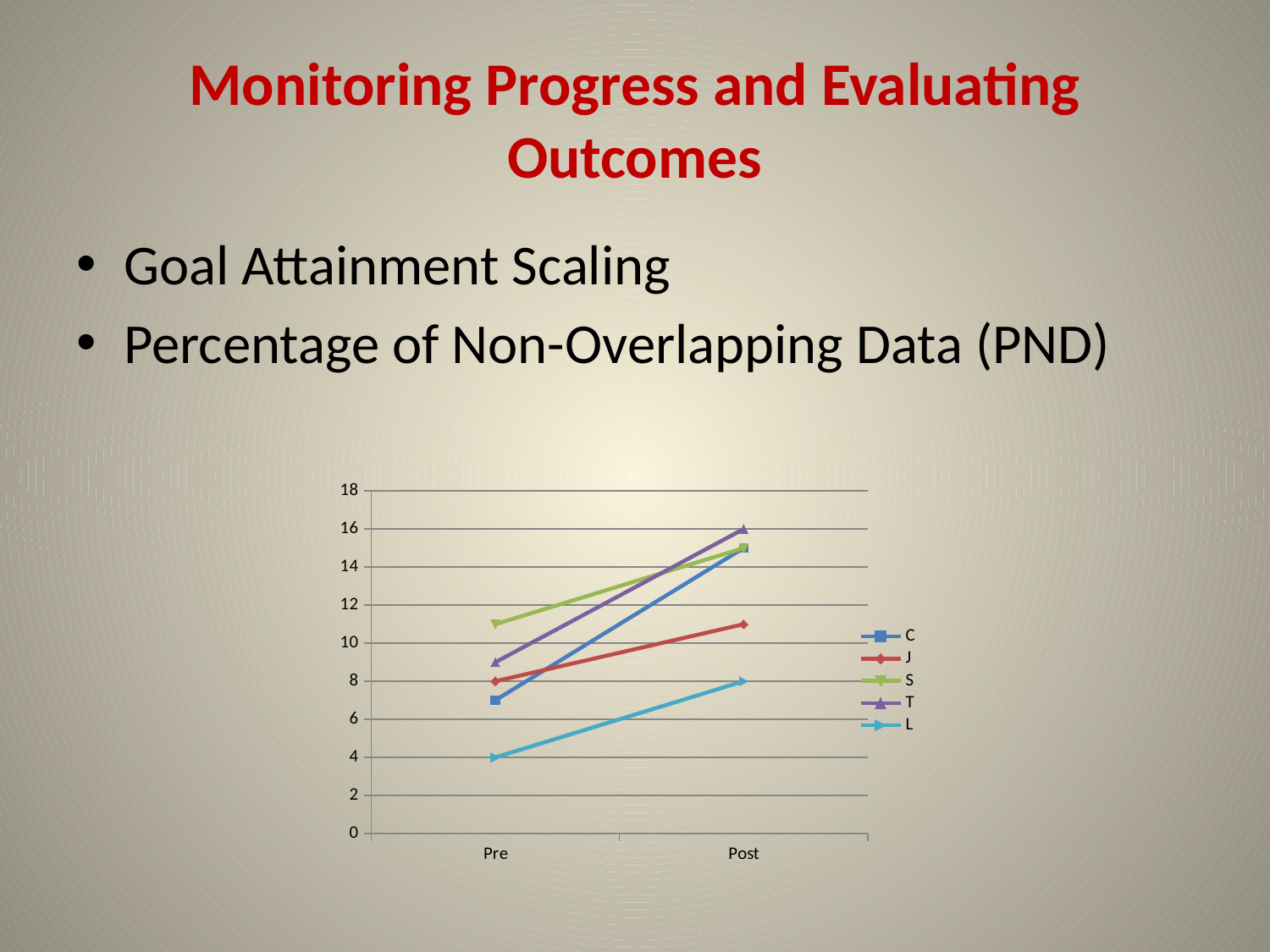
What is the value for series L at Pre? 4 Which series has the highest value at Post? T Which series has the lowest value at Pre? L What is the value for series L at Post? 8 Which is larger at Post, series J or series S? S How many series does the legend list? 5 What is the value for series T at Post? 16 What is the value for series J at Pre? 8 Do the values for series S rise or fall from Pre to Post? rise How many categories are on the x axis? 2 Is the value for series C at Pre greater or less than 8? less What kind of chart is shown on the slide? line chart